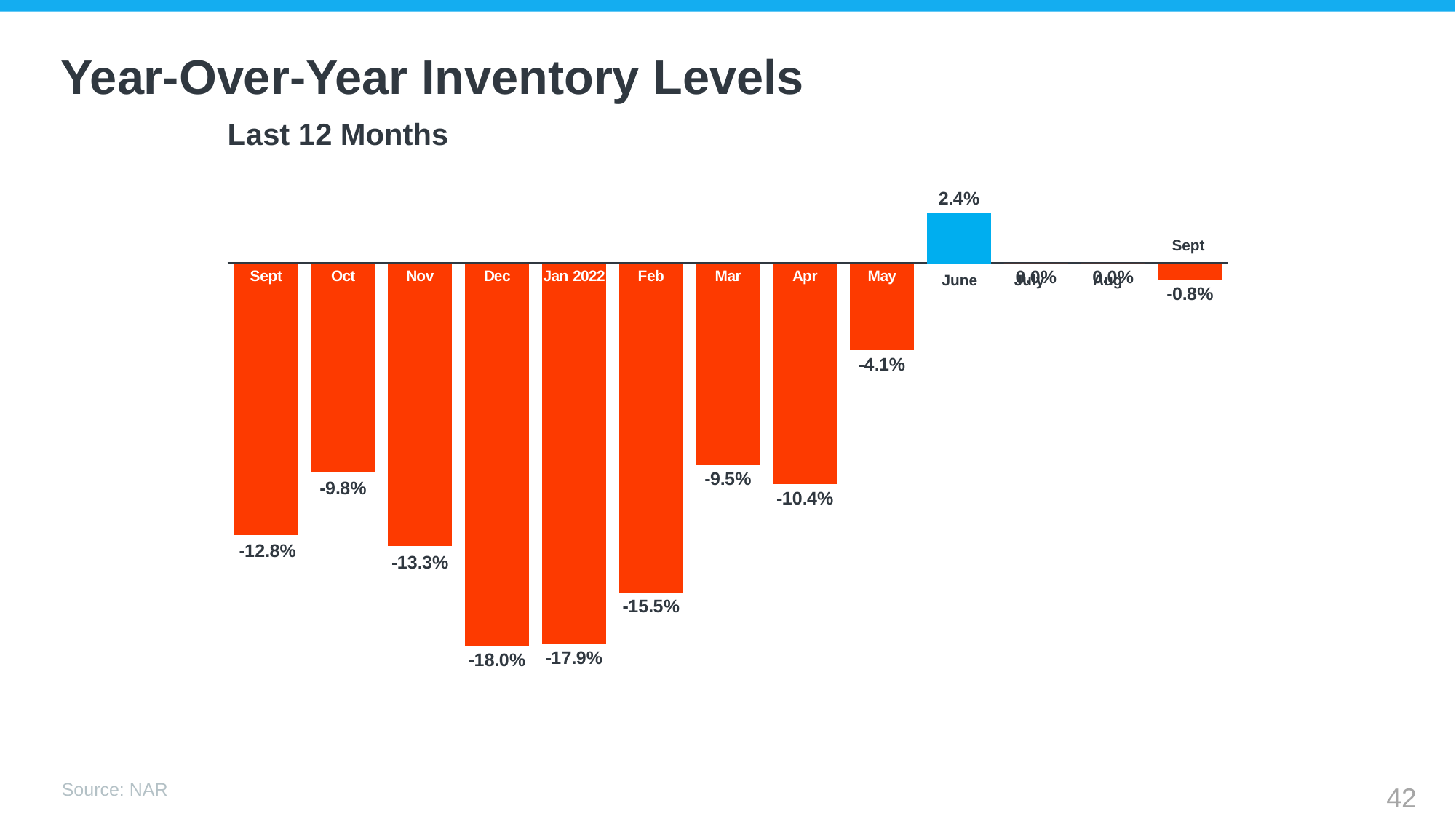
What is the year-over-year inventory level value for Dec? -18.0% What is the difference in percentage points between the Dec value (-18.0%) and the Jan 2022 value (-17.9%)? 0.1 percentage points What is the difference in percentage points between the leftmost Sept value (-12.8%) and the rightmost Sept value (-0.8%)? 12.0 percentage points Which month shows a larger decline, Oct or Nov? Nov What is the value shown for June? 2.4% Which month has the lowest value on the chart? Dec What kind of chart is shown on the slide? Bar chart What is the value shown for May? -4.1% How many bars (months) are plotted on the chart? 13 Which bar is coloured blue instead of orange? June What is the value shown for the rightmost bar, Sept? -0.8% Which month has the highest value on the chart? June